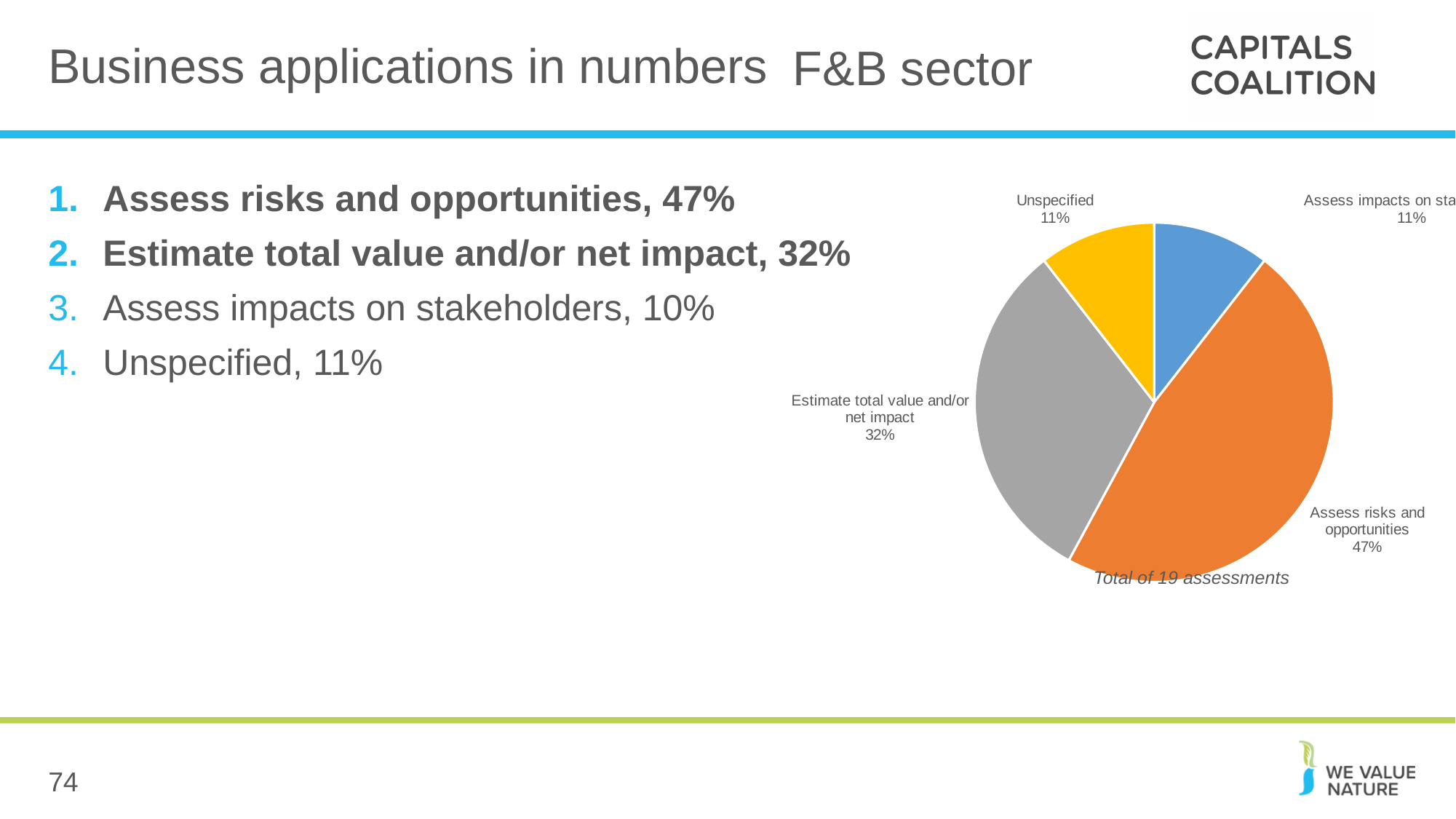
According to the note below the pie chart, how many assessments does the chart cover in total? 19 assessments What is the difference in percentage points between 'Estimate total value and/or net impact' and 'Unspecified'? 21 percentage points Which is larger in the pie chart: 'Estimate total value and/or net impact' or 'Unspecified'? Estimate total value and/or net impact What percentage is shown for the 'Unspecified' slice of the pie chart? 11% Which slice of the pie chart is the largest? Assess risks and opportunities What colour is the 'Assess risks and opportunities' slice in the pie chart? Orange What is the difference in percentage points between 'Assess risks and opportunities' and 'Estimate total value and/or net impact'? 15 percentage points What share of the pie does the 'Unspecified' slice represent? 11% What kind of chart is shown on the slide? Pie chart How many slices does the pie chart have? 4 What percentage is shown for 'Estimate total value and/or net impact' in the pie chart? 32% What percentage of the pie is labelled for 'Assess risks and opportunities'? 47%